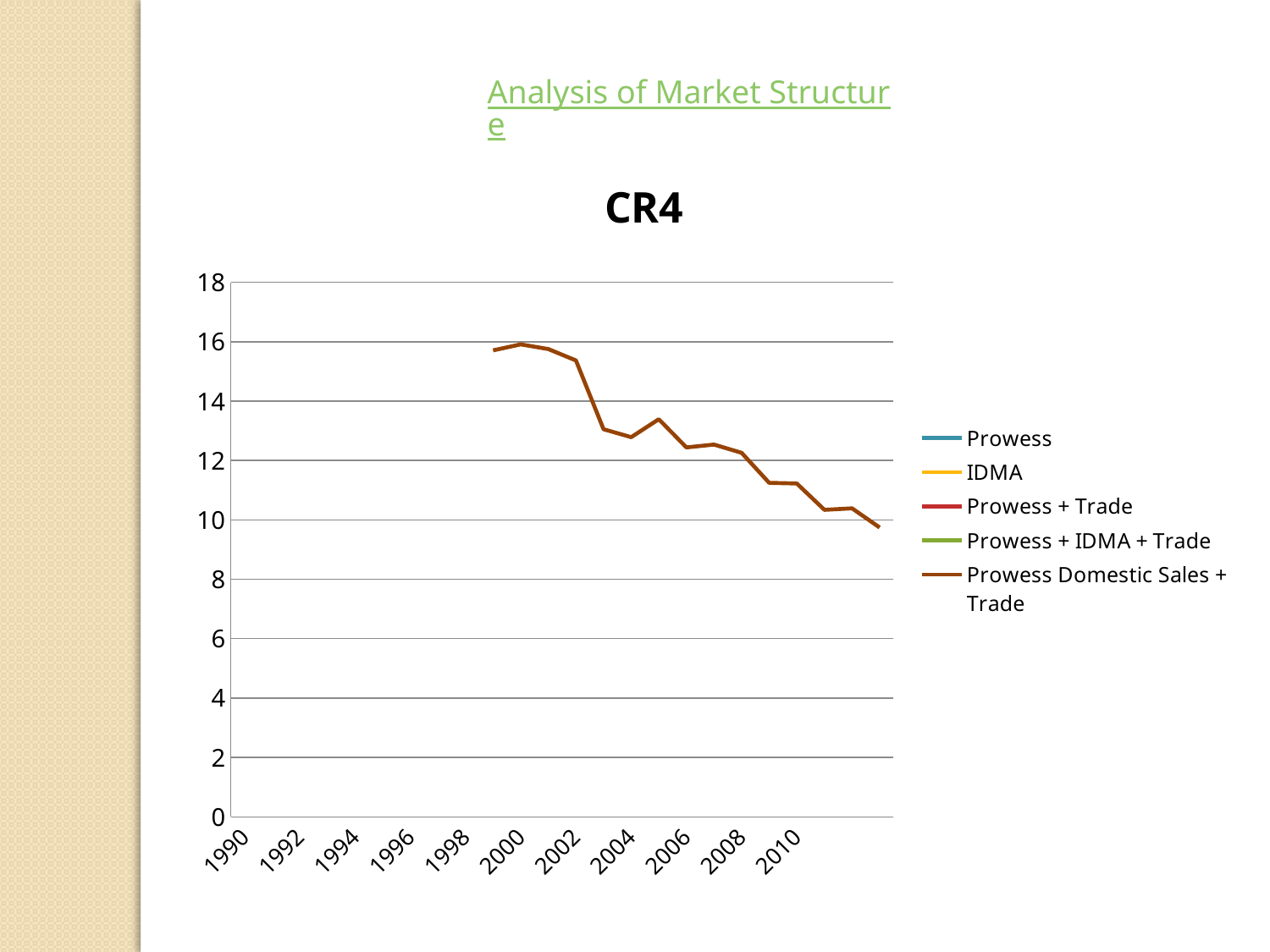
Is the value for 2000 greater or less than 14? greater Is the value for 2004 greater or less than 14? less How many year labels are shown on the x axis? 11 Is the value for 2010 greater or less than 12? less What kind of chart is shown on the slide? line chart How many series does the legend list? 5 Which year has the larger value, 2000 or 2010? 2000 Which year has the larger value, 2002 or 2004? 2002 What is the title of the chart? CR4 Does the plotted line generally rise or fall from 2000 to 2010? fall Which legend entry corresponds to the brown line that is plotted on the chart? Prowess Domestic Sales + Trade